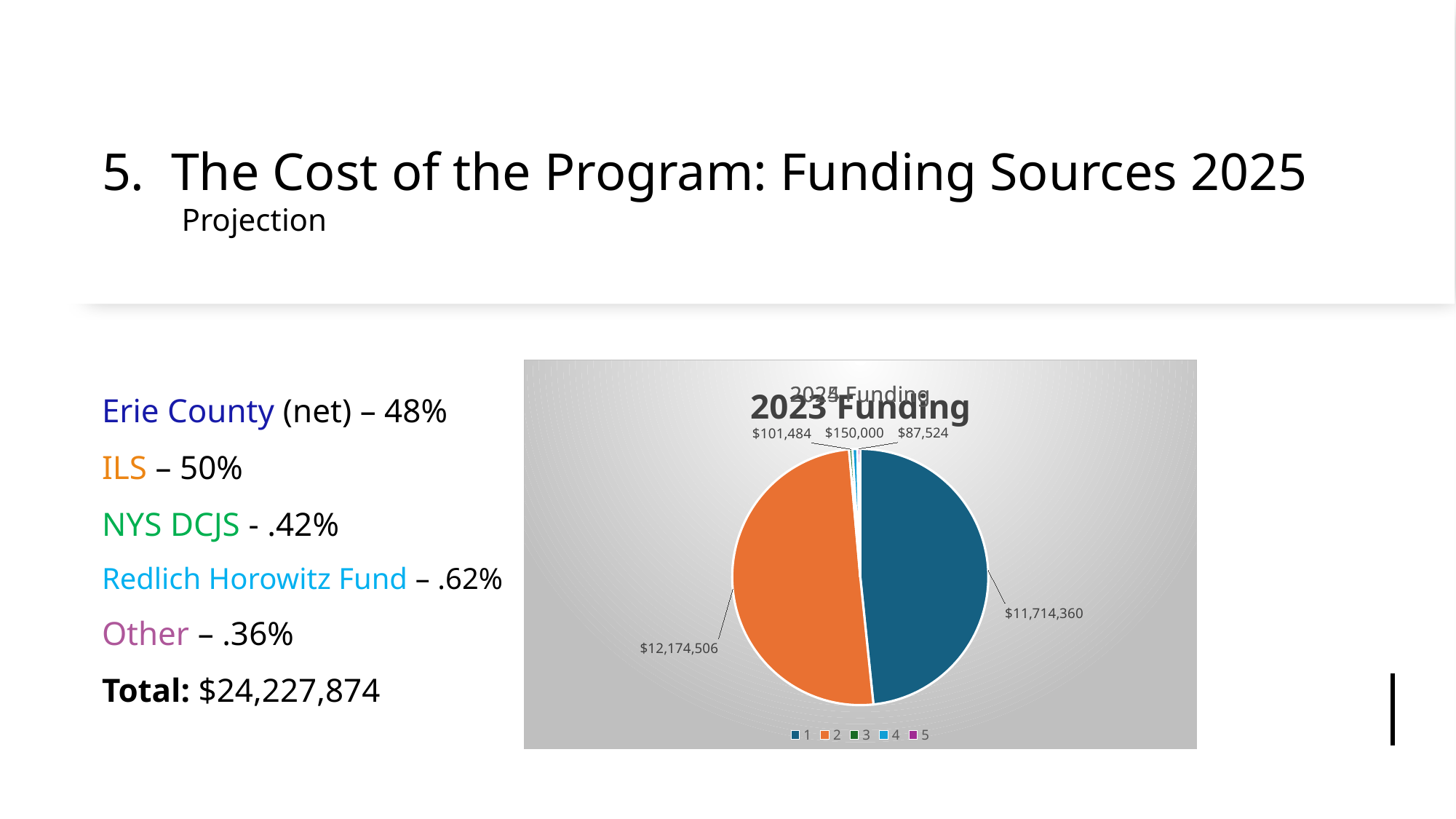
What is the largest value printed on the pie chart? $12,174,506 What colour is the slice labelled $11,714,360? blue What kind of chart is shown on the slide? pie chart What is the total of all five values printed on the pie chart? $24,227,874 Which slice is larger, the blue slice or the orange slice? orange What is the smallest value printed on the pie chart? $87,524 What is the value printed on the blue slice of the pie chart? $11,714,360 How many entries does the pie chart's legend list? 5 What is the value printed on the orange slice of the pie chart? $12,174,506 How many data labels are printed on the pie chart? 5 What is the difference between the orange slice ($12,174,506) and the blue slice ($11,714,360)? $460,146